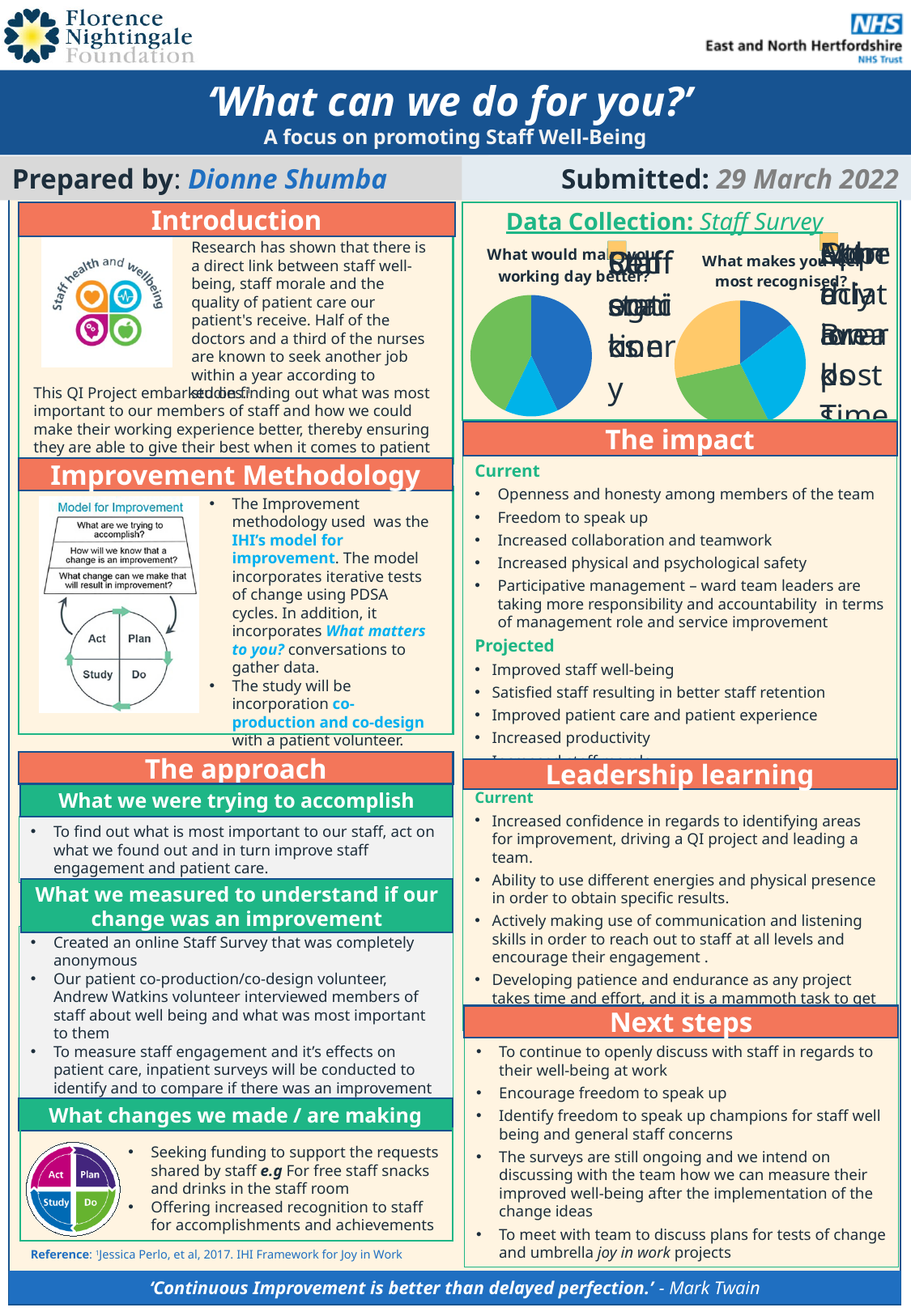
How many slices does the "What makes you feel most recognised?" pie chart have? 4 What kind of chart is used for "What would make your working day better?"? pie chart In the "What would make your working day better?" pie chart, which colour slice is the smallest? light blue What kind of chart is used for "What makes you feel most recognised?"? pie chart What is the heading of the section that contains the two pie charts? Data Collection: Staff Survey How many pie charts are shown in the Data Collection section of the slide? 2 How many slices does the "What would make your working day better?" pie chart have? 3